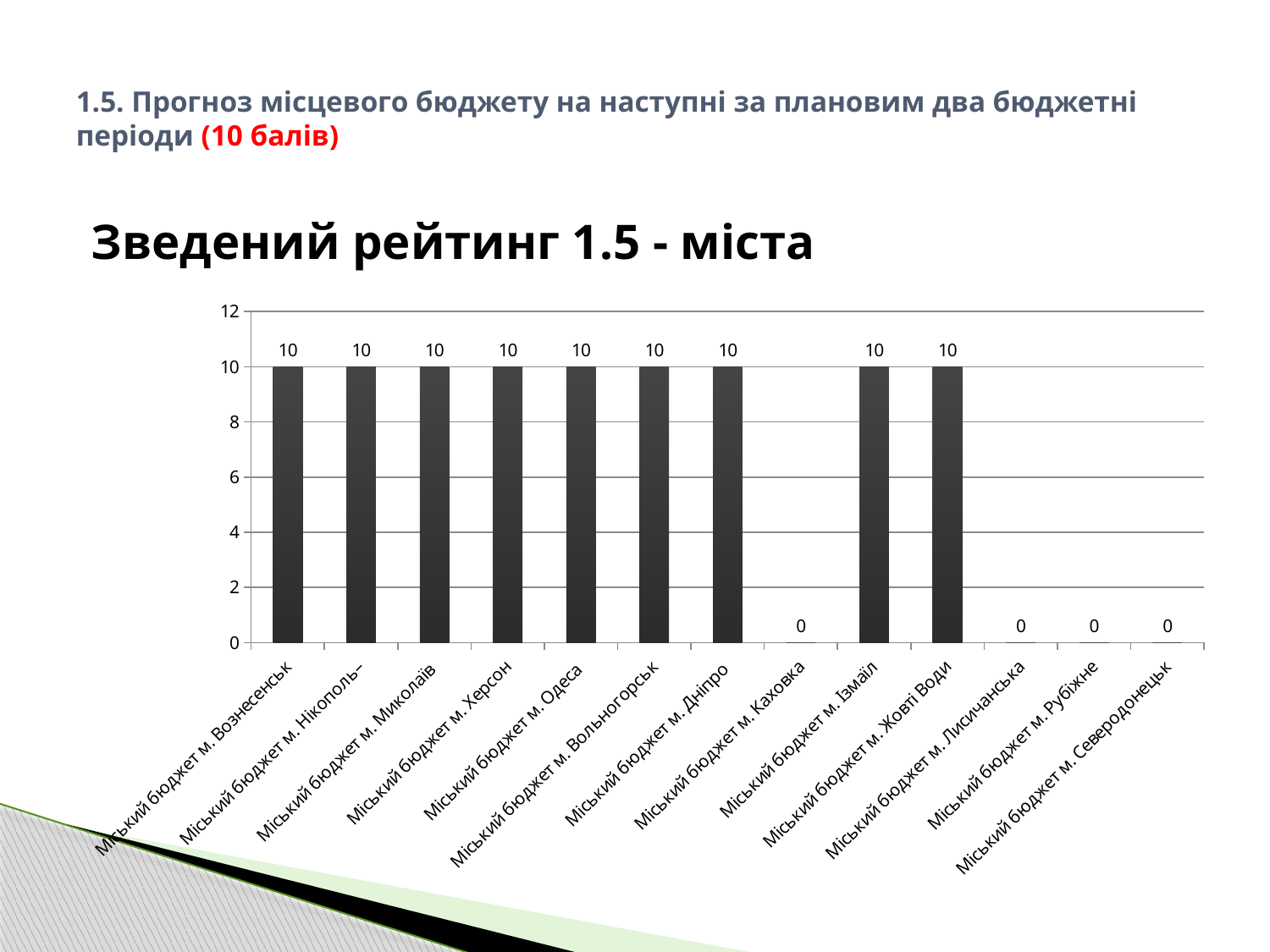
What is the value for Міський бюджет м. Дніпро? 10 How many categories have a value of 0? 4 Is the value for Міський бюджет м. Херсон greater or less than 6? greater What is the title of the chart? Зведений рейтинг 1.5 - міста What is the value for Міський бюджет м. Ізмаїл? 10 How many categories are shown on the x axis of the chart? 13 What is the difference between the value for Міський бюджет м. Одеса and the value for Міський бюджет м. Рубіжне? 10 Which is larger, the value for Міський бюджет м. Жовті Води or the value for Міський бюджет м. Лисичанська? Міський бюджет м. Жовті Води What is the value for Міський бюджет м. Северодонецьк? 0 What is the value for Міський бюджет м. Вознесенськ? 10 What kind of chart is shown on the slide? bar chart What is the value for Міський бюджет м. Каховка? 0